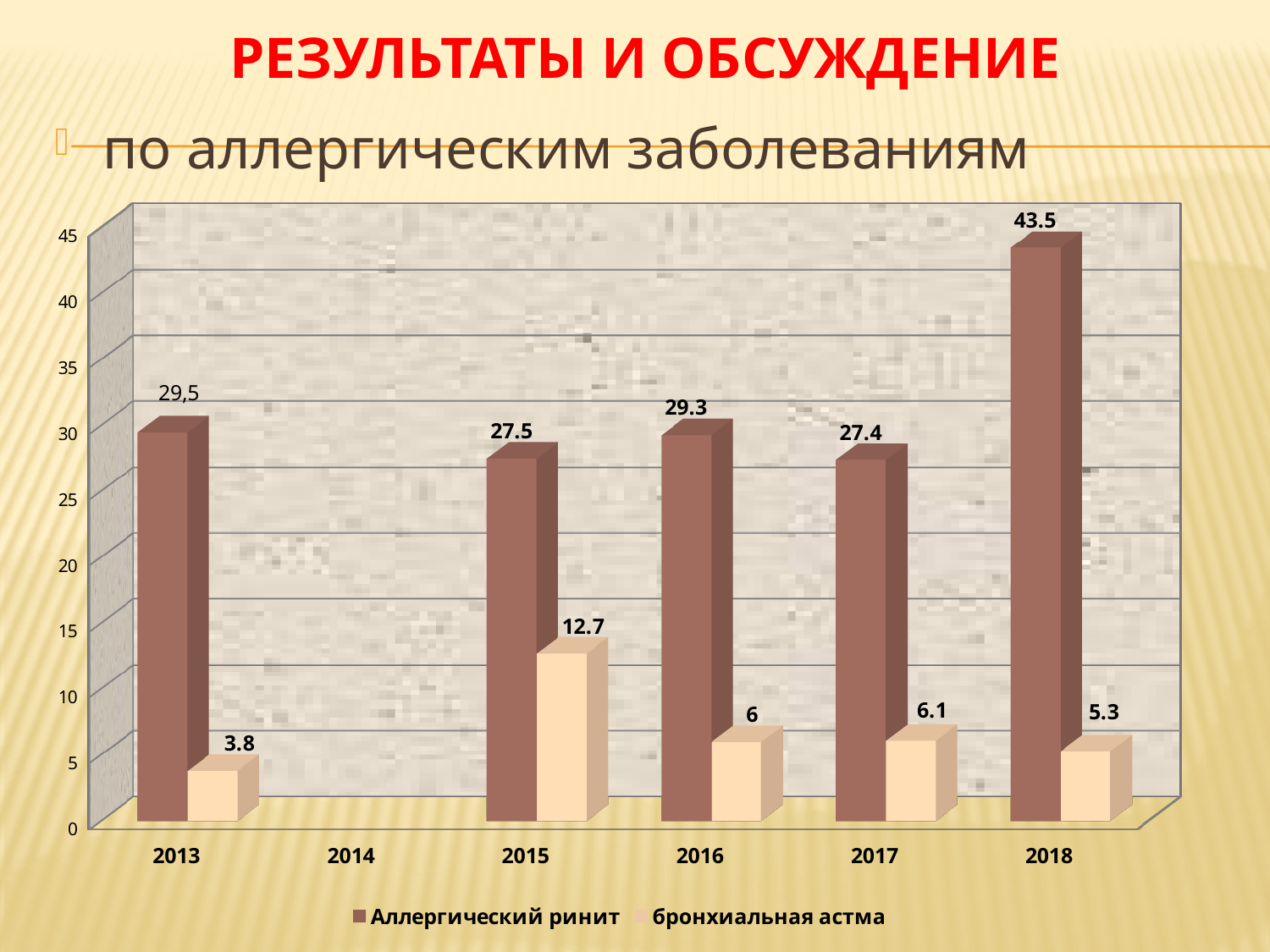
How many years are labelled on the x axis? 6 Which is larger: the бронхиальная астма value for 2015 or for 2018? 2015 Is the value for Аллергический ринит in 2018 greater or less than 40? greater What is the difference between the Аллергический ринит values for 2018 and 2016? 14.2 How many series does the legend list? 2 What is the value for бронхиальная астма in 2017? 6.1 What is the value for Аллергический ринит in 2018? 43.5 In which year is the value for Аллергический ринит highest? 2018 What is the value for Аллергический ринит in 2013? 29,5 What is the value for бронхиальная астма in 2015? 12.7 In which year is the value for бронхиальная астма lowest? 2013 What kind of chart is shown on the slide? bar chart